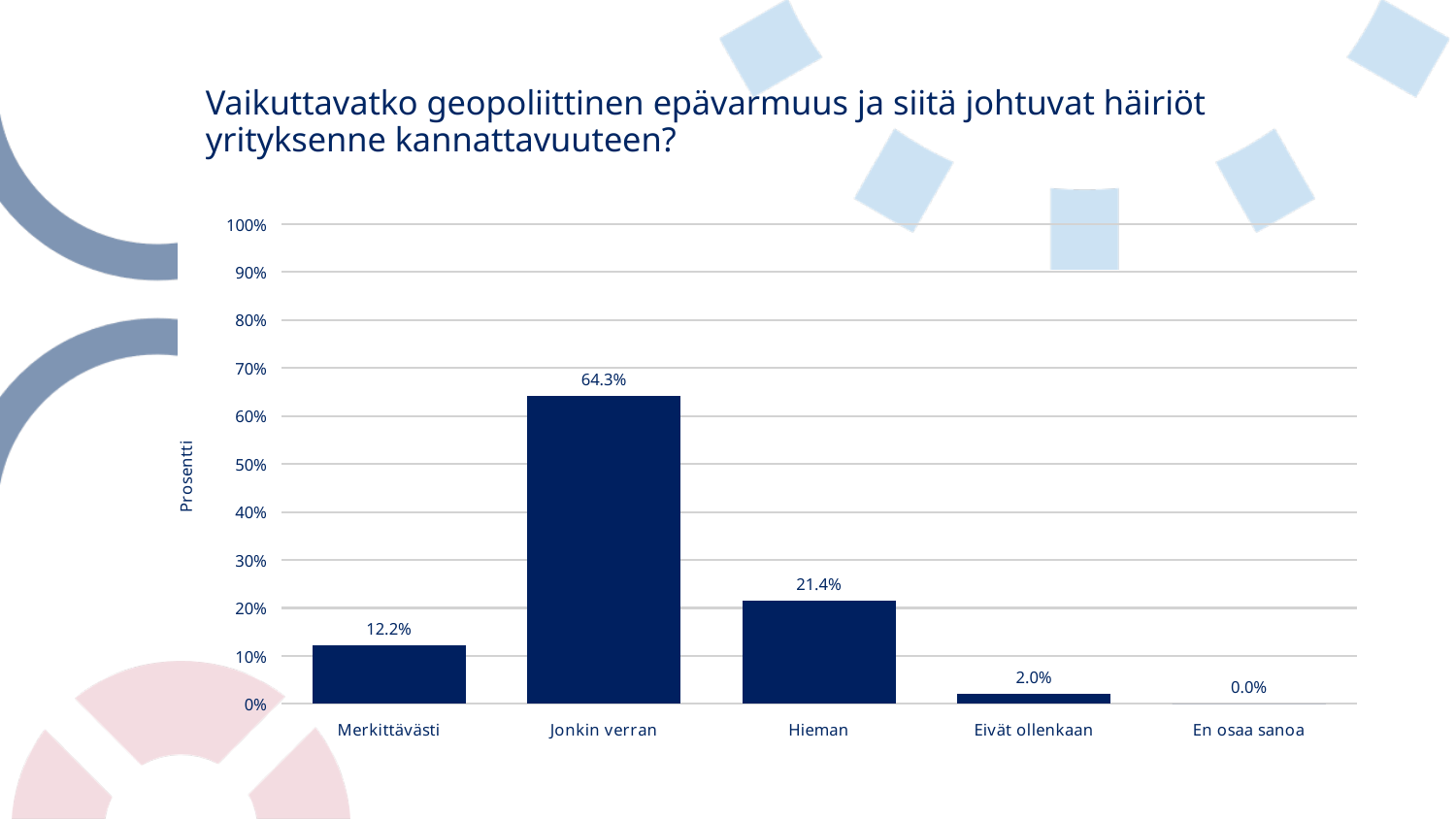
How many categories are shown on the x axis? 5 What is the value for "Eivät ollenkaan"? 2.0% Which is larger, the value for "Hieman" or the value for "Merkittävästi"? Hieman Which category has the lowest value? En osaa sanoa What is the value for "Jonkin verran"? 64.3% What is the label of the y axis? Prosentti Is the value for "Jonkin verran" greater or less than 60%? greater What is the difference between the values for "Jonkin verran" and "Hieman"? 42.9% What is the value for "En osaa sanoa"? 0.0% What kind of chart is shown on the slide? Bar chart What is the value for "Merkittävästi"? 12.2% Which category has the highest value? Jonkin verran